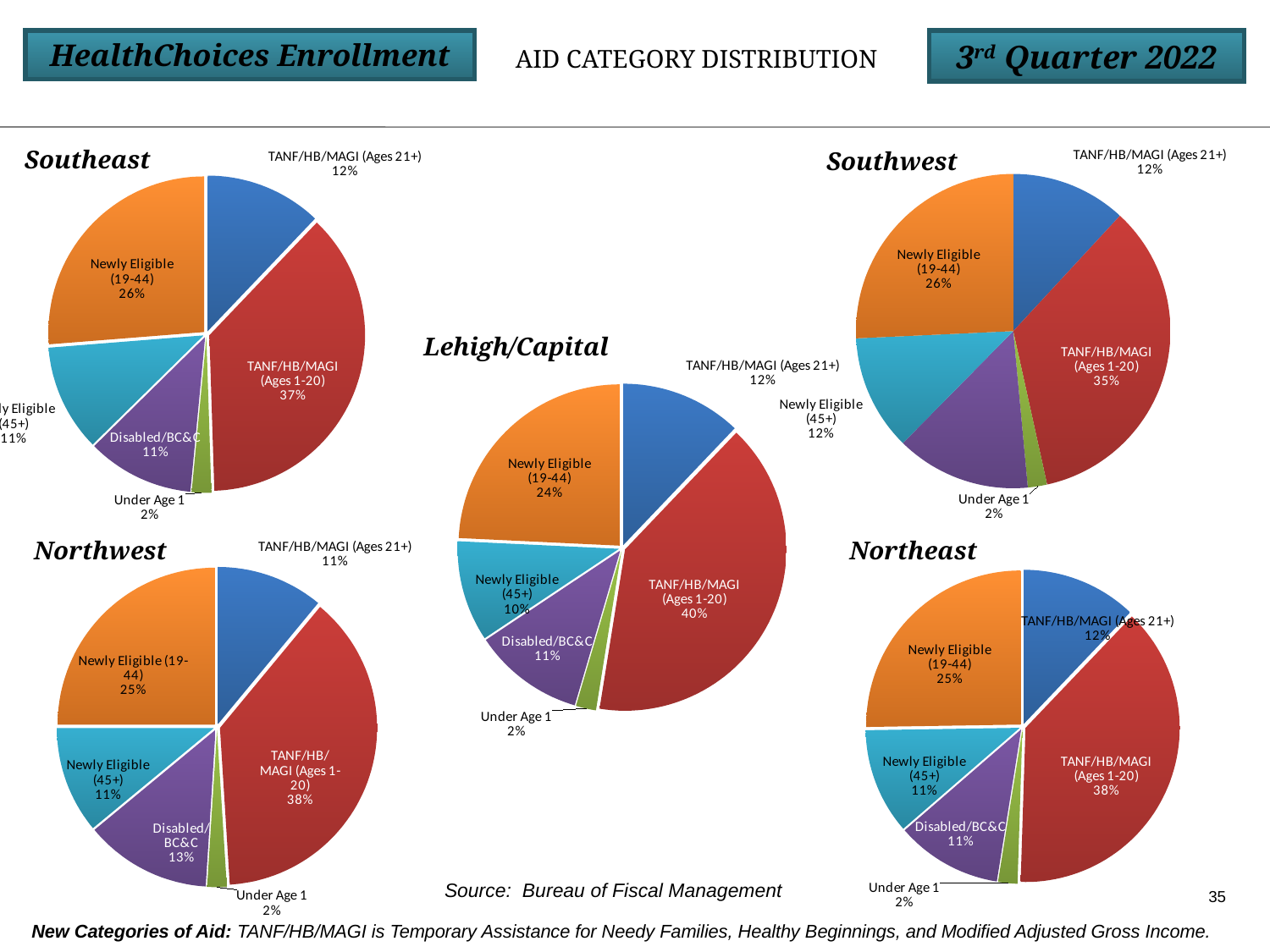
In the Southeast pie chart, what is the difference between the TANF/HB/MAGI (Ages 1-20) share and the Newly Eligible (19-44) share? 11 percentage points In the Northwest pie chart, what share is Disabled/BC&C? 13% In the Northeast pie chart, what share is TANF/HB/MAGI (Ages 1-20)? 38% In the Southwest pie chart, what share is Newly Eligible (45+)? 12% What type of chart is used for the Northeast region? Pie chart What is the title of the chart in the centre of the slide? Lehigh/Capital In the Lehigh/Capital pie chart, which category has the largest share? TANF/HB/MAGI (Ages 1-20) In the Southeast pie chart, what share is TANF/HB/MAGI (Ages 1-20)? 37% In the Lehigh/Capital pie chart, what share is Newly Eligible (19-44)? 24% How many pie charts are shown on the slide? 5 In the Northwest pie chart, which category has the smallest share? Under Age 1 Which is larger: the TANF/HB/MAGI (Ages 1-20) share in the Lehigh/Capital chart or in the Southwest chart? Lehigh/Capital